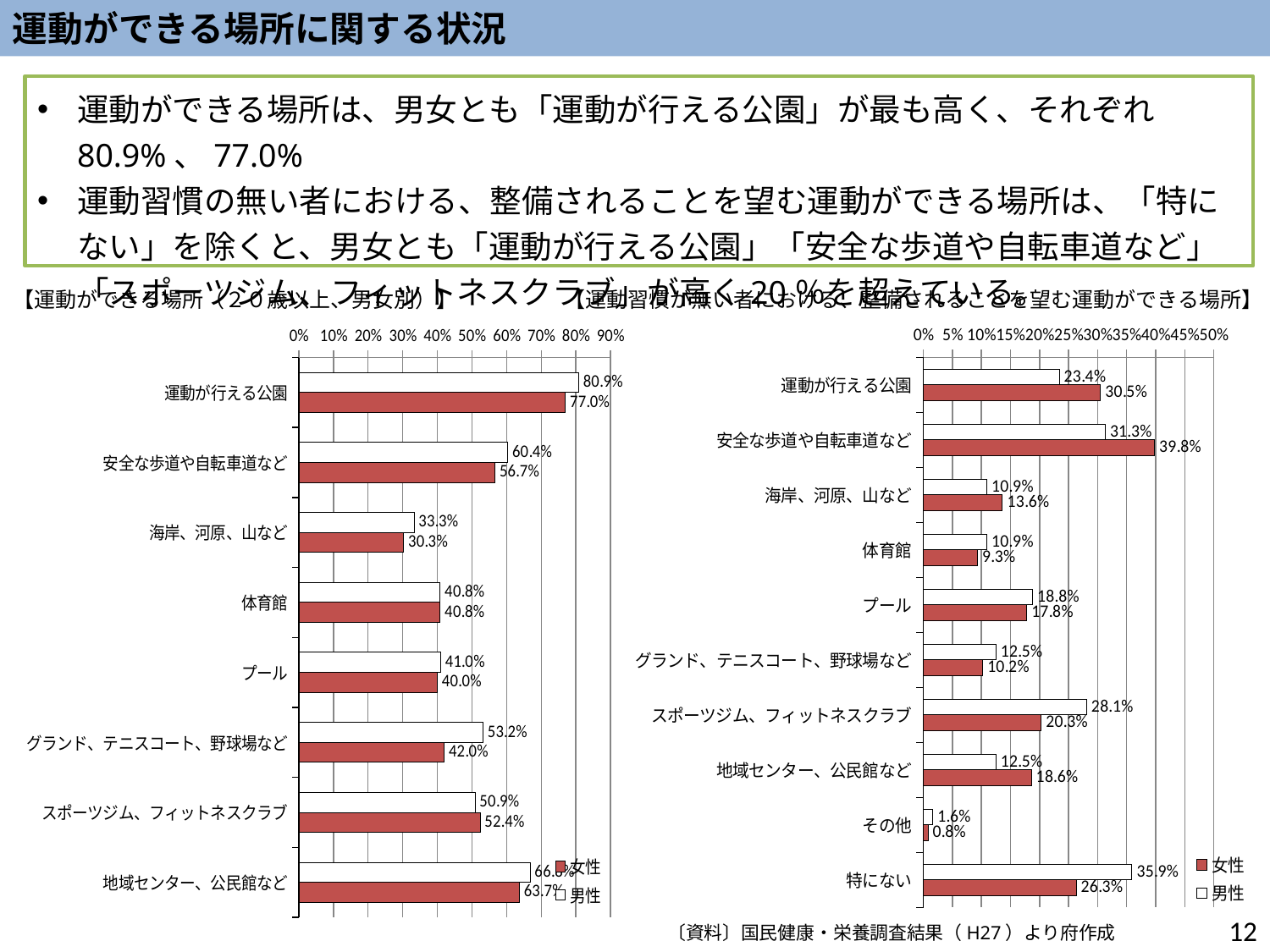
In the left chart, which category has the lowest 男性 value? 海岸、河原、山など In the left chart, which is larger for スポーツジム、フィットネスクラブ: the 男性 value or the 女性 value? 女性 In the left chart, which category has the highest 女性 value? 運動が行える公園 In the right chart, what is the value for 女性 for 安全な歩道や自転車道など? 39.8% How many categories does the right chart show? 10 What type of chart is the left chart? Bar chart In the left chart, what is the value for 男性 for 運動が行える公園? 80.9% In the right chart, which category has the lowest 女性 value? その他 In the right chart, what is the difference between the 女性 and 男性 values for 運動が行える公園? 7.1% In the left chart, what is the value for 女性 for 安全な歩道や自転車道など? 56.7% In the right chart, what is the value for 男性 for 特にない? 35.9% In the left chart, what is the difference between the 男性 and 女性 values for グランド、テニスコート、野球場など? 11.2%